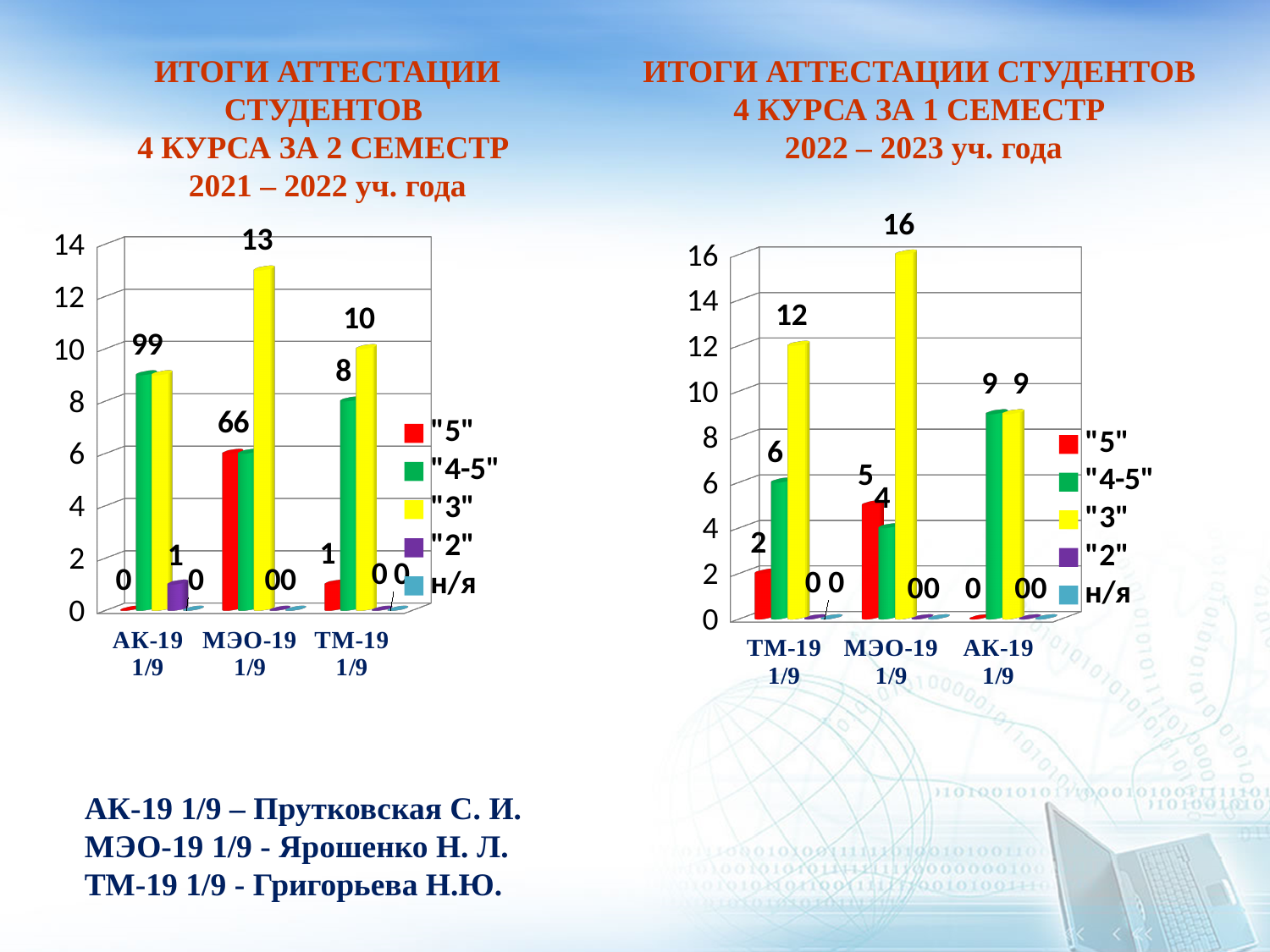
In the right chart (1 семестр 2022 – 2023), what is the value of "5" for ТМ-19 1/9? 2 How many series does the legend of the left chart (2 семестр 2021 – 2022) list? 5 In the right chart (1 семестр 2022 – 2023), which is larger for МЭО-19 1/9: "5" or "4-5"? "5" In the left chart (2 семестр 2021 – 2022), which group has the lowest value for "3"? АК-19 1/9 In the left chart (2 семестр 2021 – 2022), what is the value of "3" for МЭО-19 1/9? 13 In the right chart (1 семестр 2022 – 2023), which group has the highest value for "3"? МЭО-19 1/9 In the right chart (1 семестр 2022 – 2023), what colour represents the "3" series? Yellow In the right chart (1 семестр 2022 – 2023), what is the value of "3" for МЭО-19 1/9? 16 In the left chart (2 семестр 2021 – 2022), what is the value of "4-5" for ТМ-19 1/9? 8 In the left chart (2 семестр 2021 – 2022), what is the difference between the "3" values for МЭО-19 1/9 and ТМ-19 1/9? 3 What type of chart is the left chart (2 семестр 2021 – 2022)? Bar chart How many groups are shown on the x axis of the right chart (1 семестр 2022 – 2023)? 3